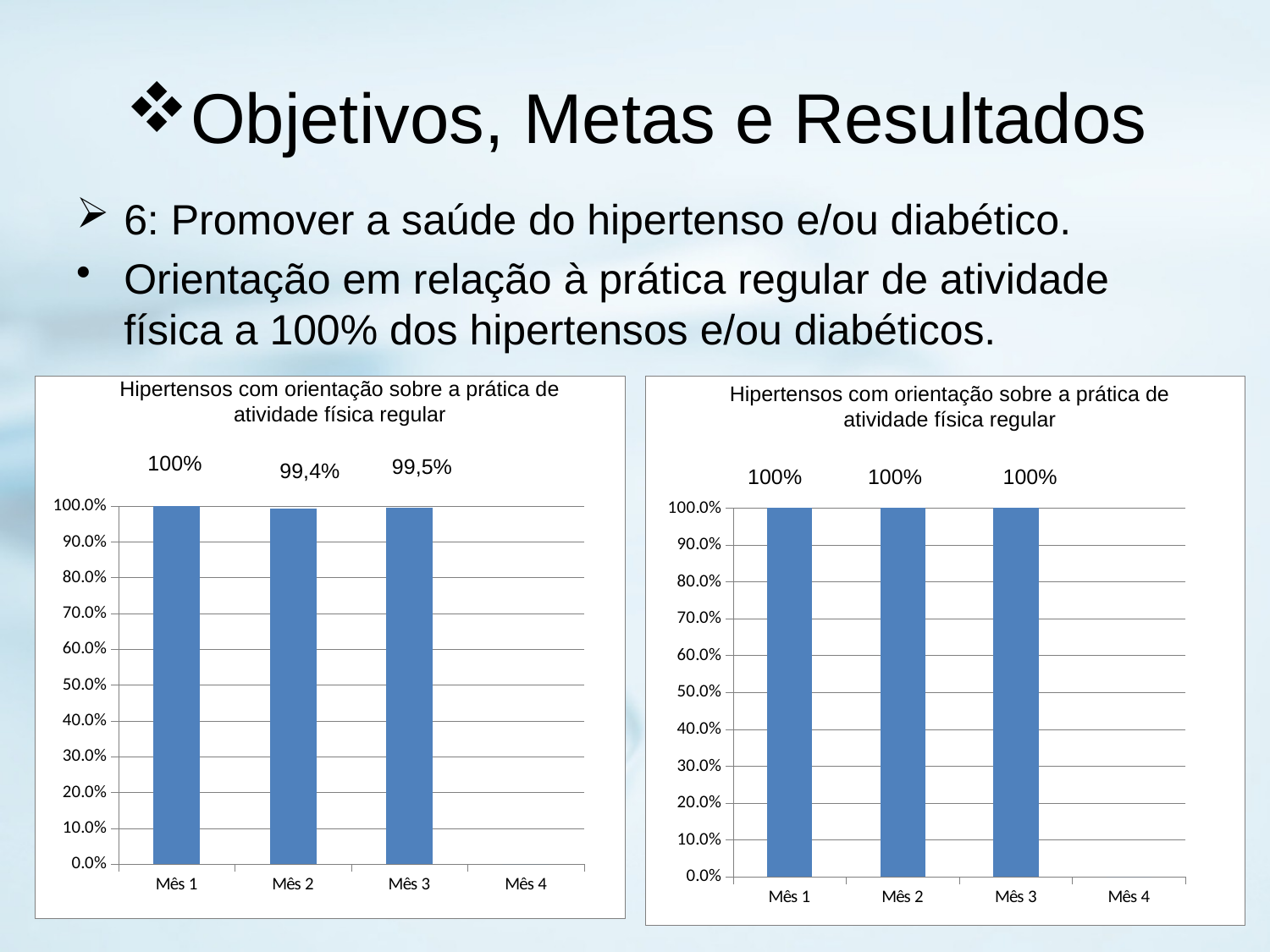
What kind of chart is the right chart? Bar chart In the left chart, what is the value for Mês 1? 100% In the left chart, what is the value for Mês 3? 99,5% In the left chart, which month has the highest value? Mês 1 In the left chart, which is larger, the value for Mês 1 or the value for Mês 3? Mês 1 In the right chart, what is the value for Mês 2? 100% In the left chart, which of the labelled months has the lowest value? Mês 2 In the left chart, what is the value for Mês 2? 99,4% What is the title of the left chart? Hipertensos com orientação sobre a prática de atividade física regular In the left chart, is the value for Mês 2 greater or less than 90.0%? greater How many month categories are shown on the x axis of the right chart? 4 In the left chart, what is the difference between the values for Mês 1 and Mês 2? 0,6%